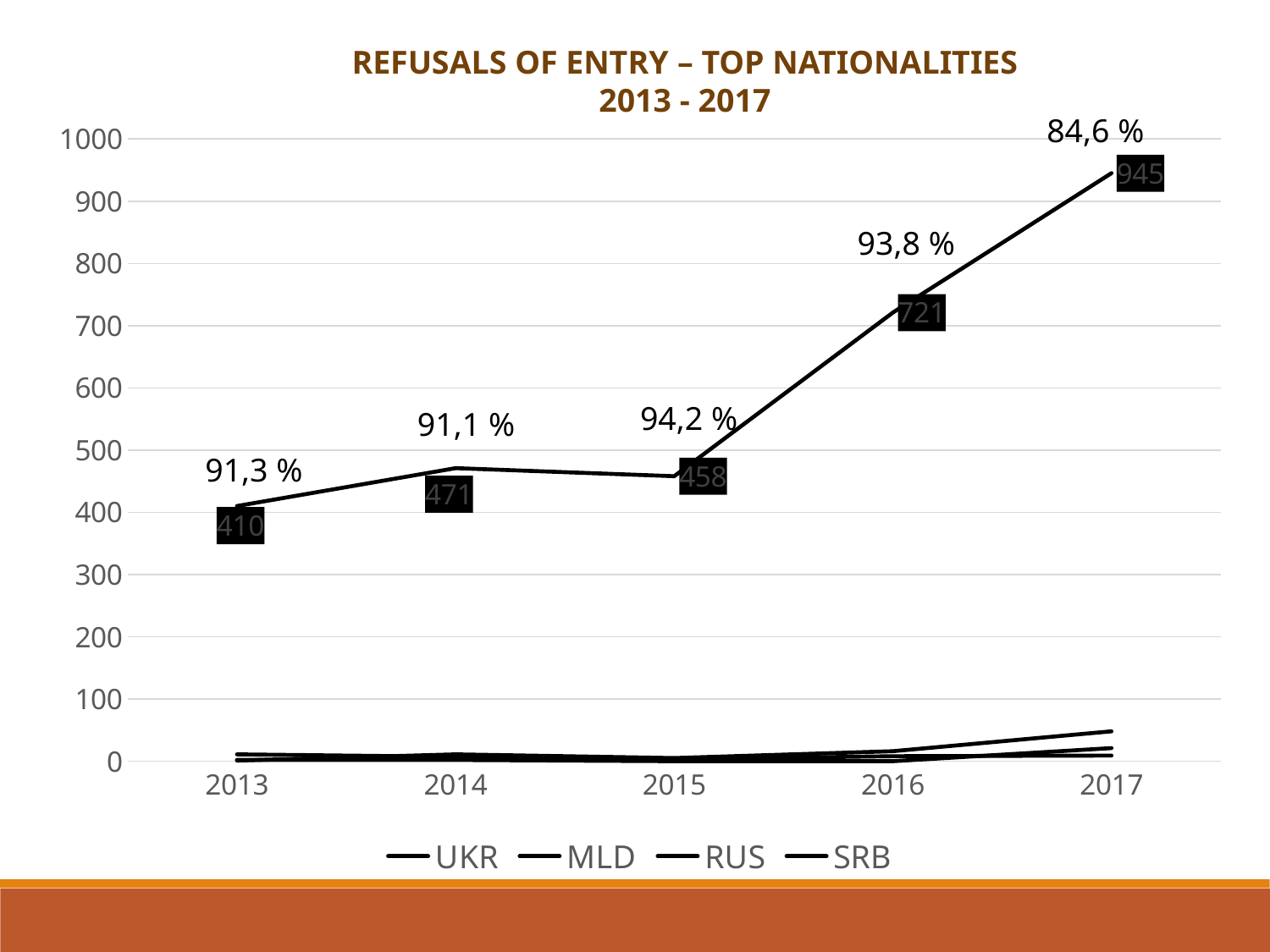
How many series does the legend list? 4 On the top line, which year has the larger value, 2014 or 2015? 2014 What percentage label is shown above the 2017 data point? 84,6 % What kind of chart is shown on the slide? line chart What is the value labelled on the top line for 2013? 410 By how much does the top line's value increase from 2016 to 2017? 224 How many years are shown on the x axis? 5 What is the value labelled on the top line for 2016? 721 In which year does the top line have its lowest value? 2013 What is the value labelled on the top line for 2017? 945 In which year does the top line reach its highest value? 2017 Does the top line rise or fall from 2015 to 2017? rise